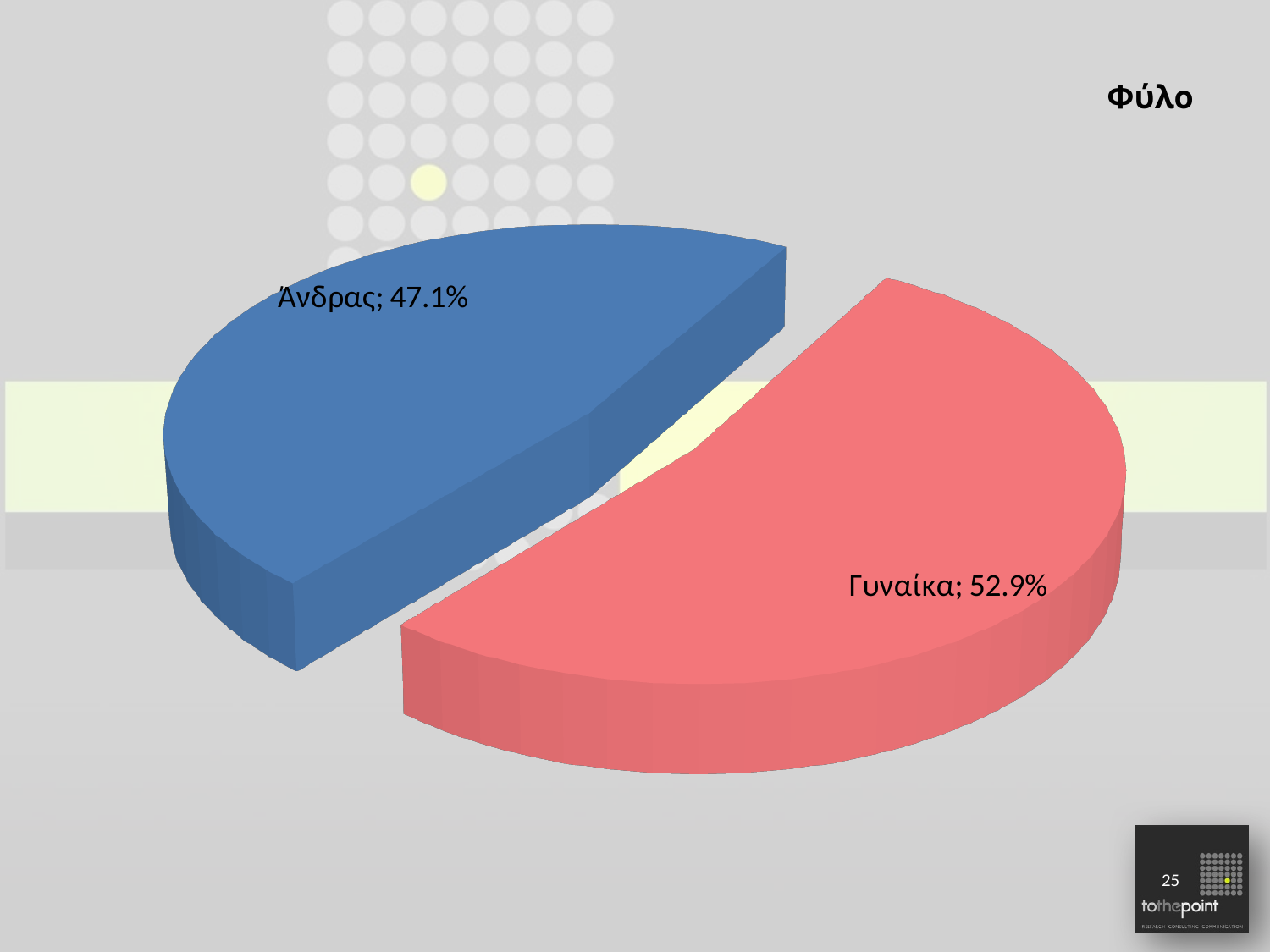
Is the share for Άνδρας greater or less than 50%? less Which category has the largest share of the pie? Γυναίκα What percentage is shown for Γυναίκα? 52.9% What type of chart is shown on the slide? Pie chart What percentage is shown for Άνδρας? 47.1% Which category has the smallest share of the pie? Άνδρας Which is larger, the share for Άνδρας or the share for Γυναίκα? Γυναίκα How many slices does the pie chart have? 2 What is the difference in percentage points between Γυναίκα and Άνδρας? 5.8 What colour is the slice for Γυναίκα? Red What is the title of the chart? Φύλο